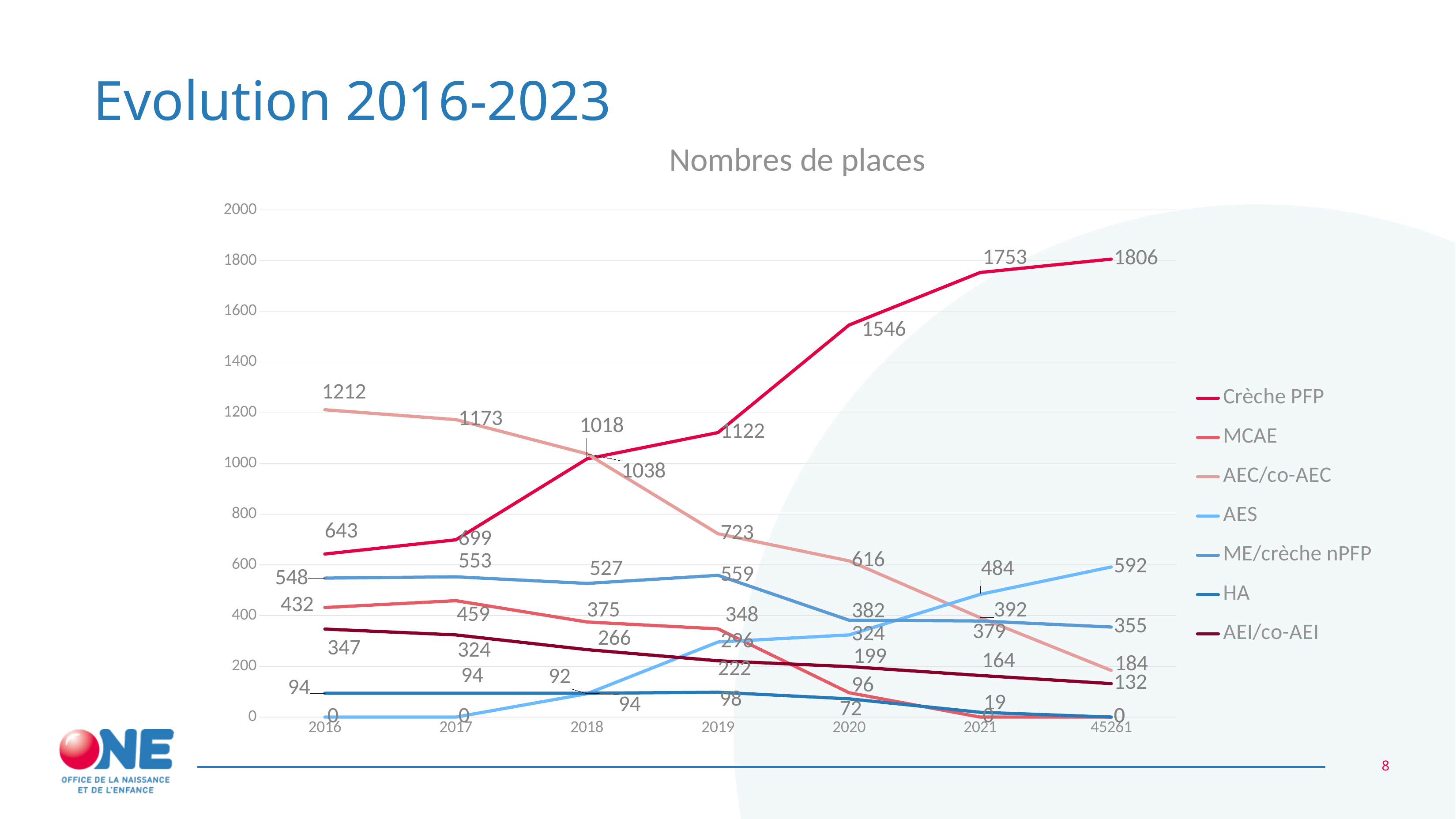
What kind of chart is shown on the slide? line chart Which is larger in 2020: ME/crèche nPFP or AES? ME/crèche nPFP What is the value for AES in 2021? 484 What is the value for Crèche PFP in 2020? 1546 What is the difference between the Crèche PFP values in 2021 and 2020? 207 How many series does the legend list? 7 What is the title of the chart? Nombres de places Which series has the highest value in 2021? Crèche PFP What is the value for AEI/co-AEI in 2019? 222 What is the value for AEC/co-AEC in 2016? 1212 Which series has the highest value in 2016? AEC/co-AEC Does the AEC/co-AEC series rise or fall from 2016 to the last point on the x axis? fall